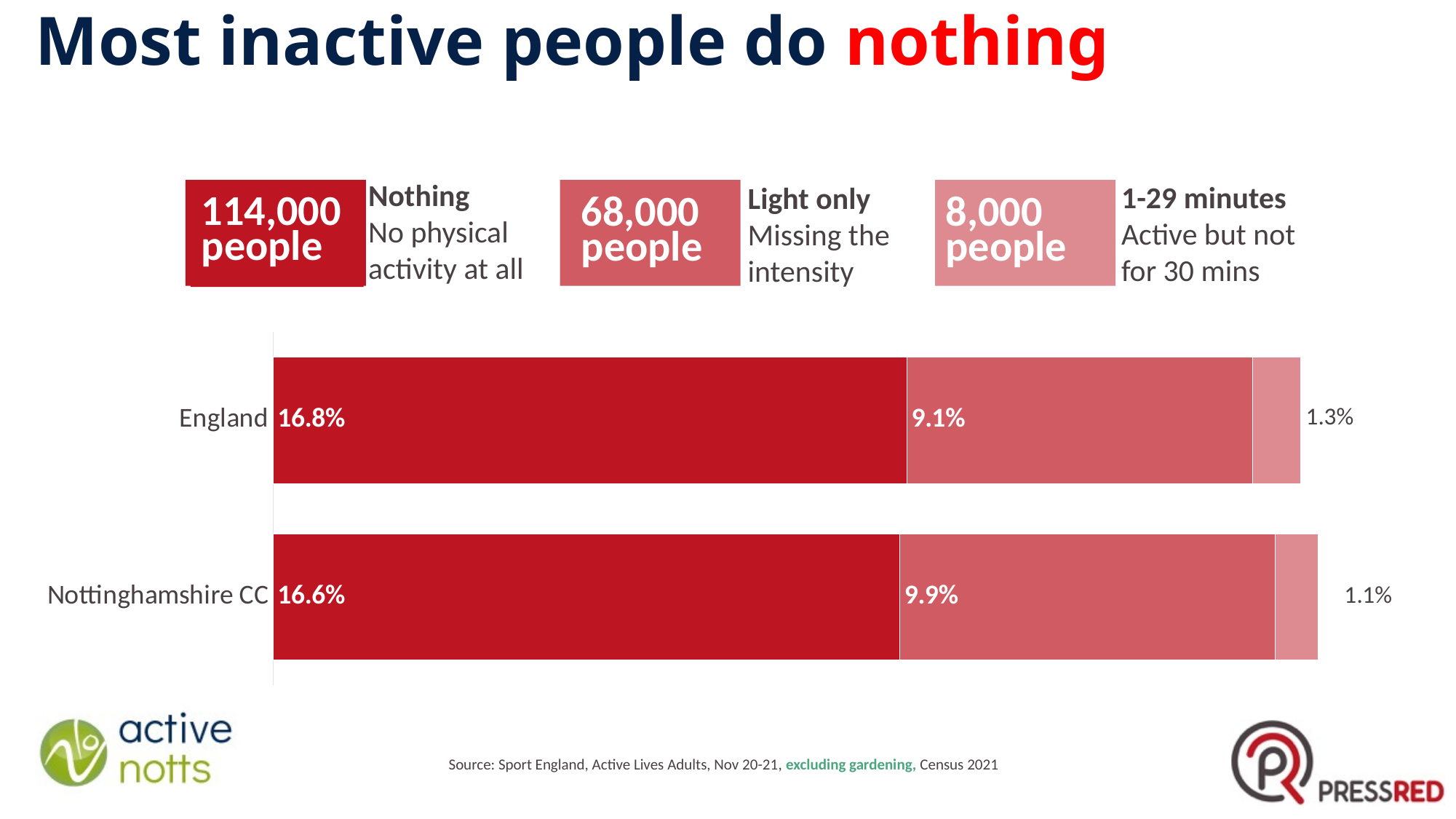
What is the difference between the Nothing values for England and Nottinghamshire CC? 0.2% What is the difference between the Light only values for Nottinghamshire CC and England? 0.8% What type of chart is shown on the slide? Stacked bar chart What is the value of the darkest red (Nothing) segment for England? 16.8% Which category has the larger Light only (middle segment) value, England or Nottinghamshire CC? Nottinghamshire CC How many categories (rows) does the bar chart show? 2 What is the value of the middle (Light only) segment for Nottinghamshire CC? 9.9% How many people in the 'Nothing' group are shown in the box above the chart? 114,000 people What is the value of the lightest (1-29 minutes) segment for England? 1.3% What is the value of the darkest red (Nothing) segment for Nottinghamshire CC? 16.6% What is the total of the stacked bar for England? 27.2% What is the total of the stacked bar for Nottinghamshire CC? 27.6%